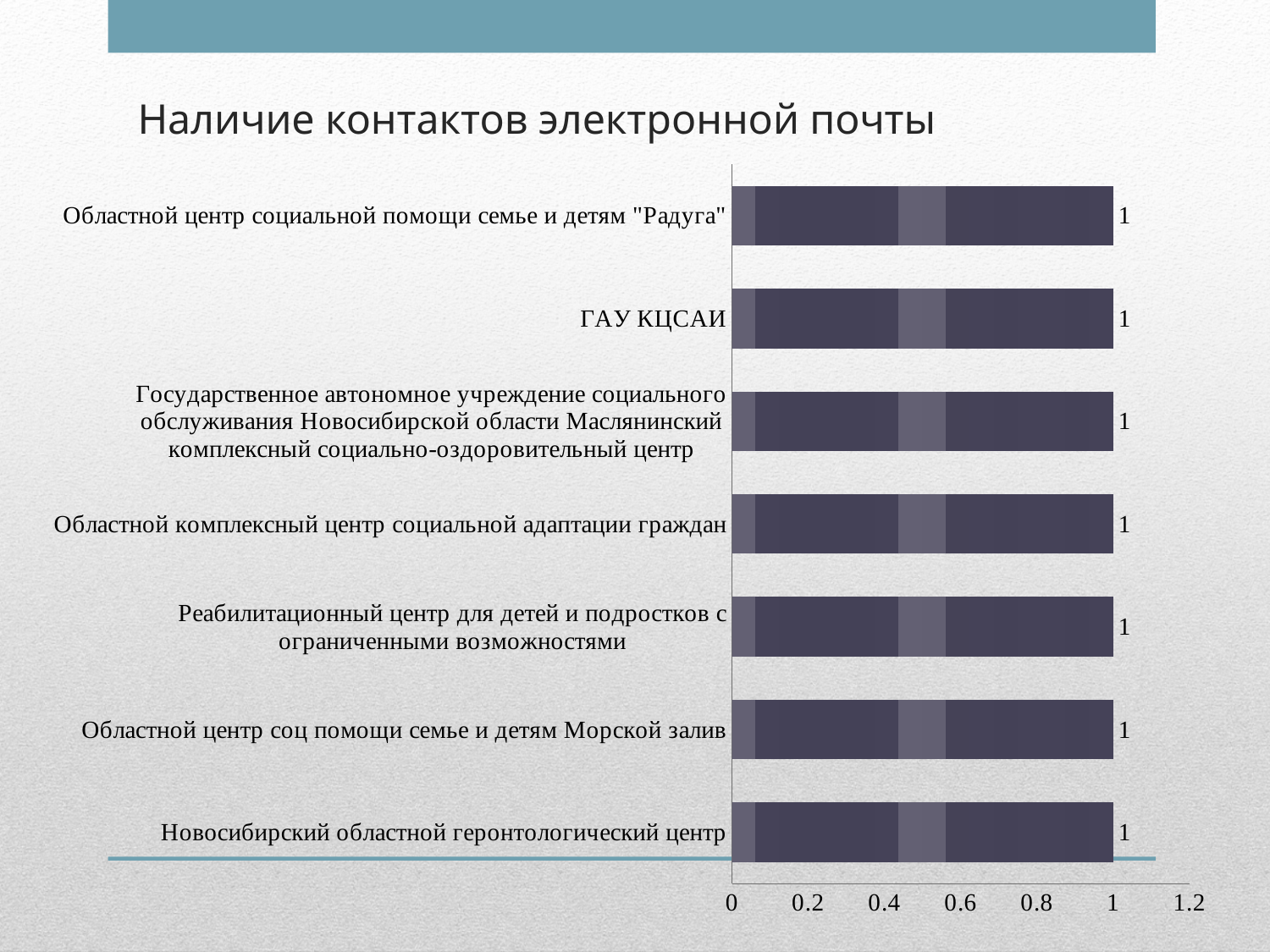
What is the value for Реабилитационный центр для детей и подростков с ограниченными возможностями? 1 Is the value for ГАУ КЦСАИ greater or less than 1.2? less What is the title of the chart? Наличие контактов электронной почты What is the value for Областной центр социальной помощи семье и детям "Радуга"? 1 What is the difference between the value for ГАУ КЦСАИ and the value for Новосибирский областной геронтологический центр? 0 Is the value for Областной комплексный центр социальной адаптации граждан greater or less than 0.8? greater How many categories (organisations) are shown in the chart? 7 What is the value for Областной центр соц помощи семье и детям Морской залив? 1 What is the highest tick value shown on the horizontal axis? 1.2 What is the value for Новосибирский областной геронтологический центр? 1 What kind of chart is shown on the slide? bar chart What is the value for ГАУ КЦСАИ? 1